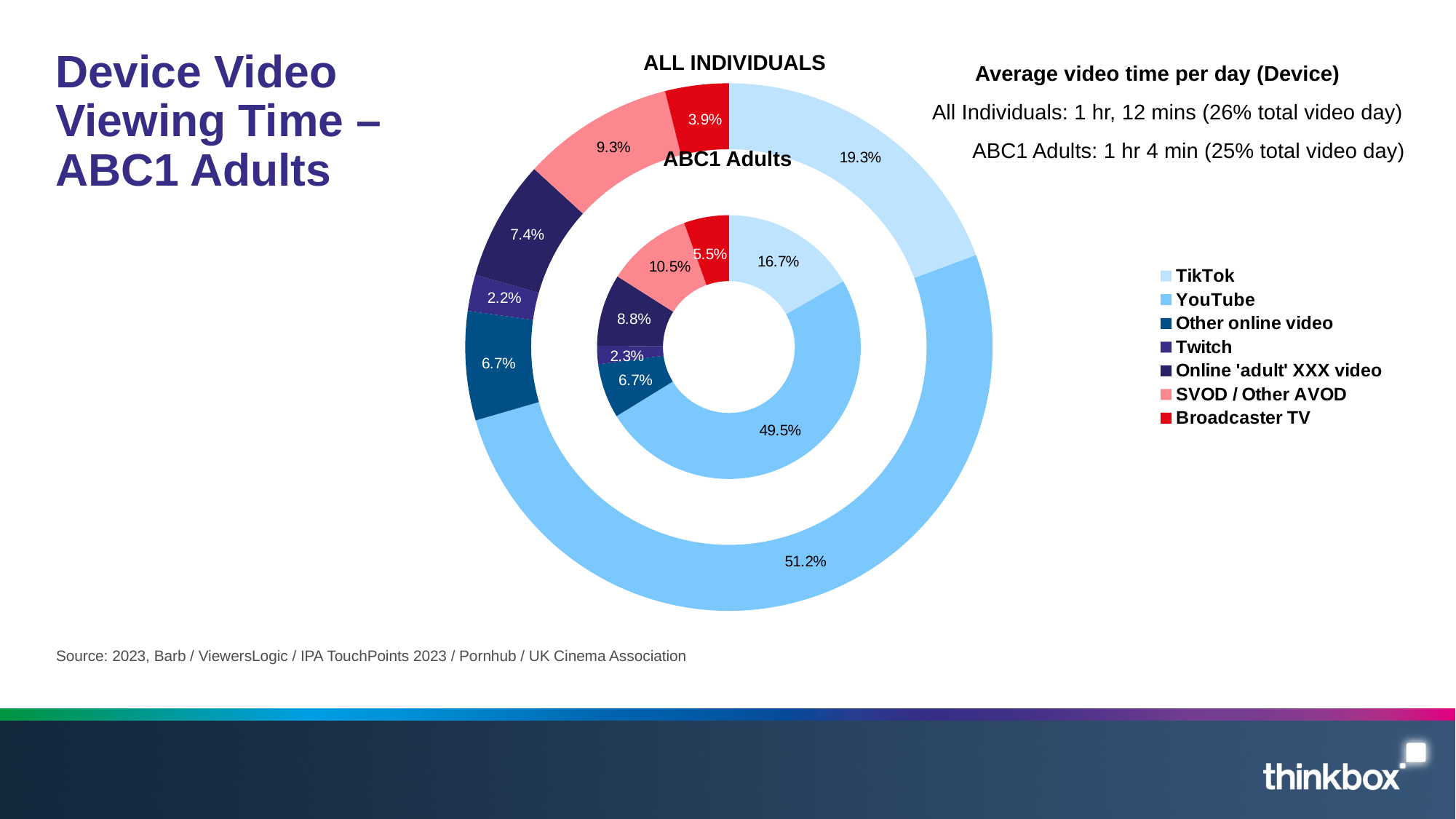
What is the Online 'adult' XXX video share for ABC1 Adults? 8.8% Which is larger: the Broadcaster TV share for ALL INDIVIDUALS or for ABC1 Adults? ABC1 Adults In the ABC1 Adults ring, what share does SVOD / Other AVOD have? 10.5% In the ABC1 Adults ring, what share does TikTok have? 16.7% Which category has the smallest share in the ABC1 Adults ring? Twitch In the ALL INDIVIDUALS ring, what share does YouTube have? 51.2% What is the difference between the TikTok share for ALL INDIVIDUALS and for ABC1 Adults? 2.6% What type of chart is shown on the slide? Doughnut chart How many categories does the legend list? 7 In the ALL INDIVIDUALS ring, what share does Broadcaster TV have? 3.9% According to the text on the slide, what is the average device video time per day for ABC1 Adults? 1 hr 4 min Which category has the largest share in the ALL INDIVIDUALS ring? YouTube